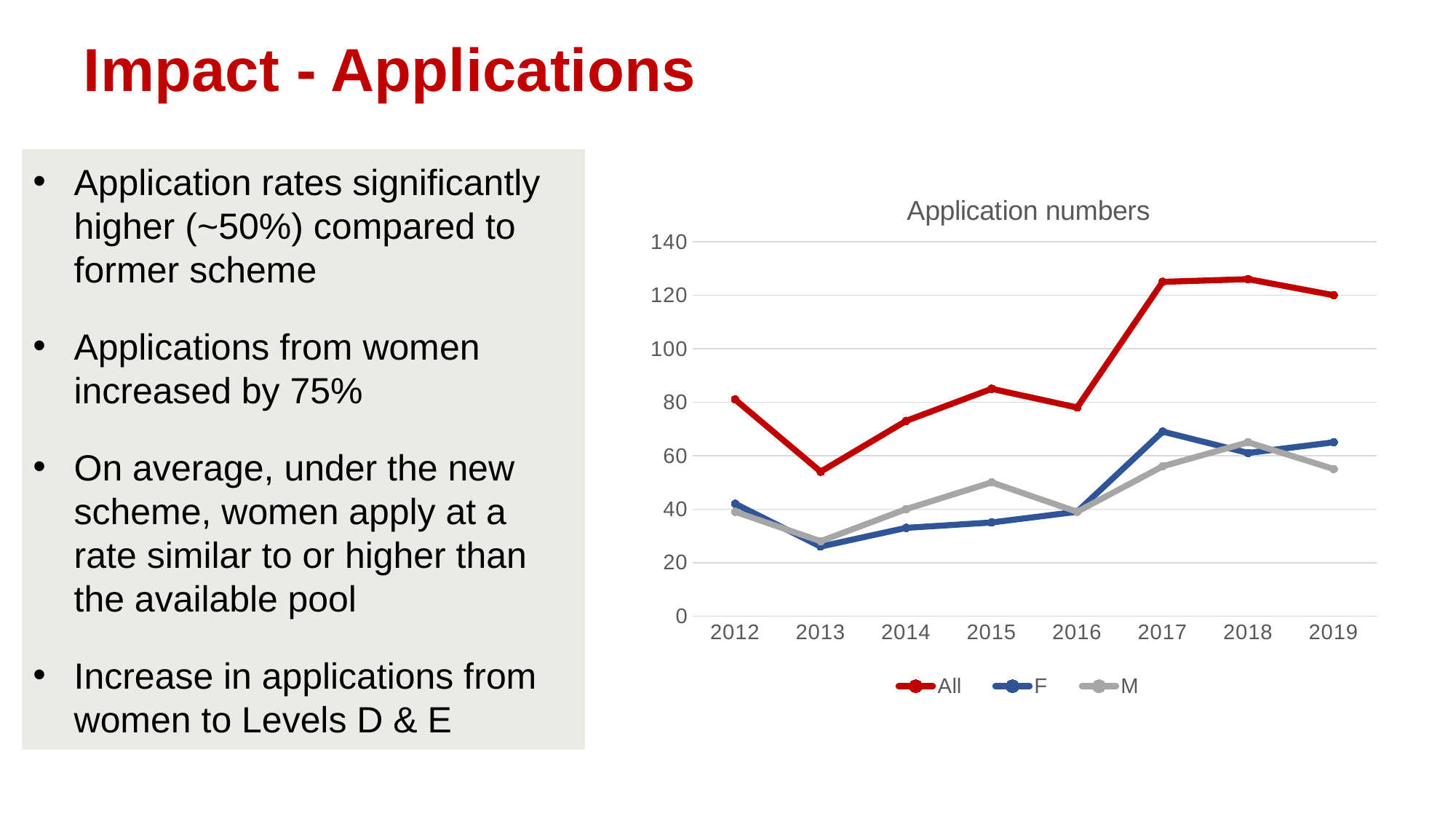
In which year is the All series at its lowest? 2013 Is the value for All in 2013 greater or less than 60? less How many years are shown on the x axis of the chart? 8 How many series does the chart legend list? 3 What is the title of the chart? Application numbers Is the value for All in 2017 greater or less than 120? greater Does the All series rise or fall from 2016 to 2017? rise In which year is the M series at its highest? 2018 What kind of chart is shown on the slide? line chart In 2015, which series has the higher value, F or M? M In which year is the F series at its highest? 2017 Is the value for M in 2015 greater or less than 40? greater